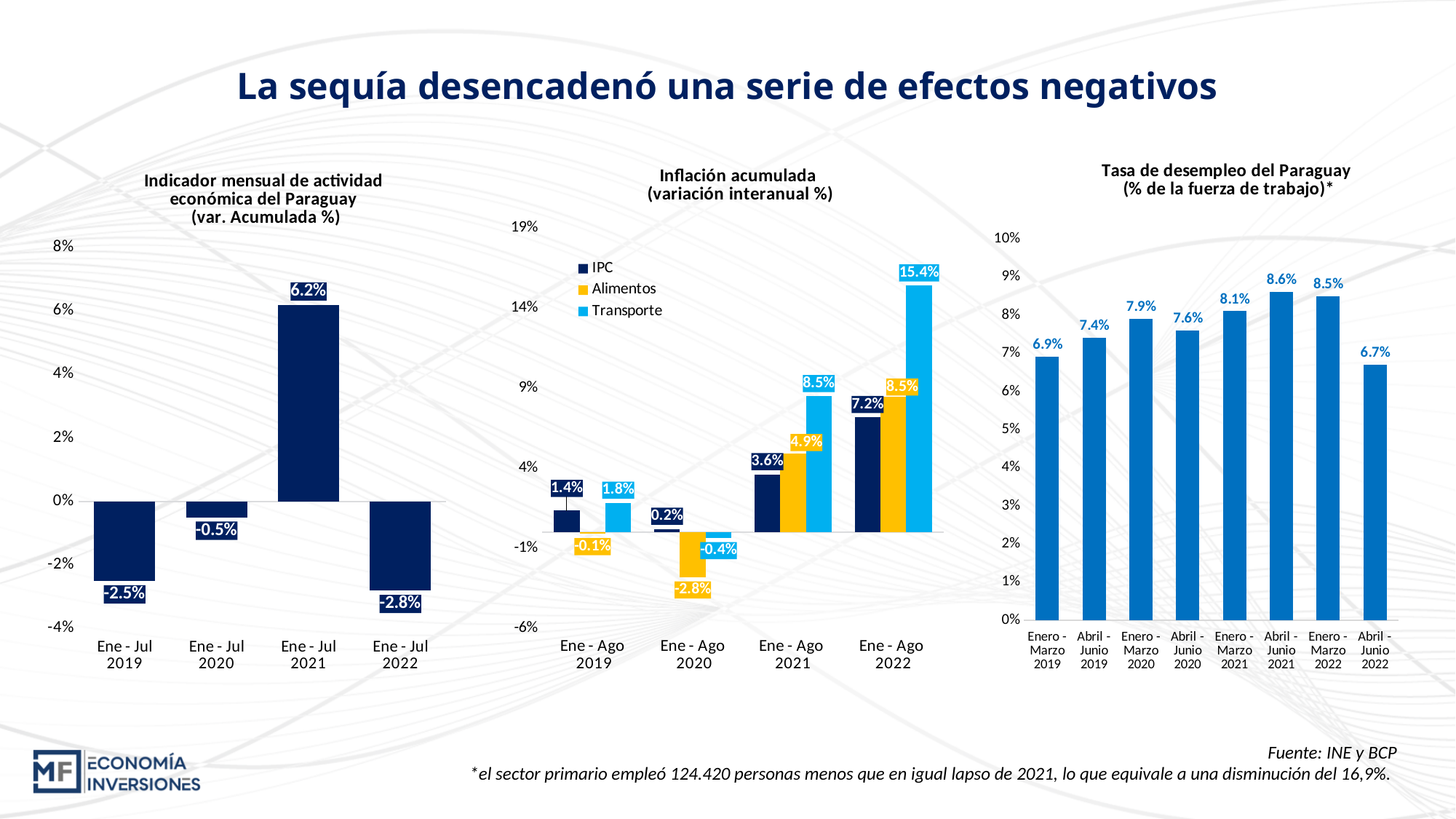
In the 'Indicador mensual de actividad económica del Paraguay' chart, which period has the lowest value? Ene - Jul 2022 In the 'Indicador mensual de actividad económica del Paraguay' chart, what is the difference between the values for Ene - Jul 2021 and Ene - Jul 2019? 8.7 percentage points What type of chart is the 'Tasa de desempleo del Paraguay' chart? Bar chart In the 'Inflación acumulada' chart, what is the difference between the Transporte and IPC values for Ene - Ago 2022? 8.2 percentage points In the 'Indicador mensual de actividad económica del Paraguay' chart, what is the value for Ene - Jul 2021? 6.2% In the 'Tasa de desempleo del Paraguay' chart, what is the value for Abril - Junio 2022? 6.7% How many periods are shown in the 'Indicador mensual de actividad económica del Paraguay' chart? 4 In the 'Inflación acumulada' chart, what is the Transporte value for Ene - Ago 2022? 15.4% In the 'Inflación acumulada' chart, which is larger for Ene - Ago 2021: IPC or Alimentos? Alimentos In the 'Tasa de desempleo del Paraguay' chart, which period has the highest unemployment rate? Abril - Junio 2021 How many series does the legend of the 'Inflación acumulada' chart list? 3 In the 'Inflación acumulada' chart, what is the Alimentos value for Ene - Ago 2020? -2.8%